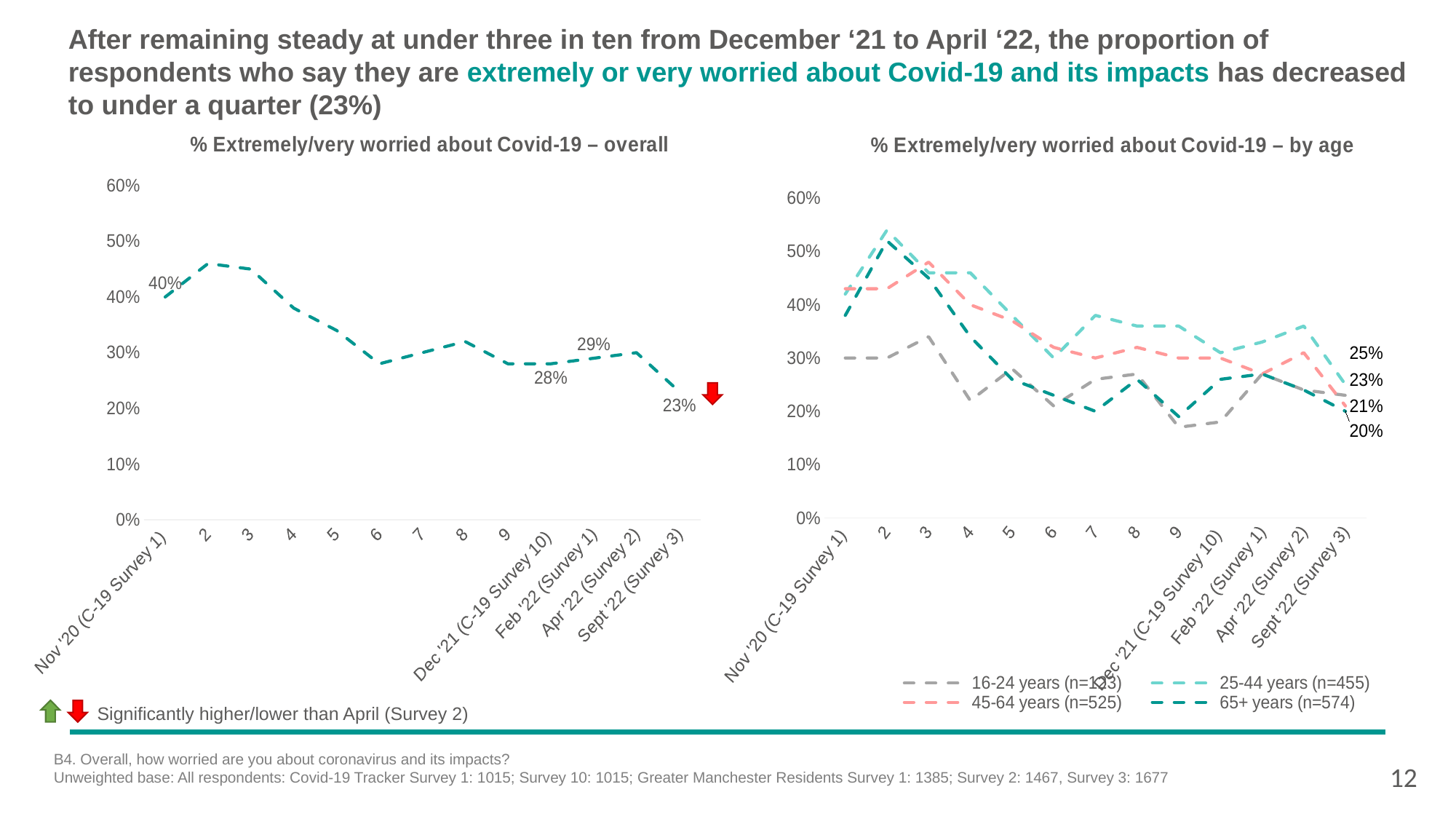
In the '% Extremely/very worried about Covid-19 – by age' chart, what is the value for 65+ years at Sept '22 (Survey 3)? 20% In the '% Extremely/very worried about Covid-19 – overall' chart, is the value at survey point 2 greater or less than 40%? greater In the '% Extremely/very worried about Covid-19 – overall' chart, what is the value for Nov '20 (C-19 Survey 1)? 40% Overall, do the values in the '% Extremely/very worried about Covid-19 – overall' chart rise or fall from Nov '20 to Sept '22? fall In the '% Extremely/very worried about Covid-19 – overall' chart, what is the value for Sept '22 (Survey 3)? 23% What type of chart is the '% Extremely/very worried about Covid-19 – overall' chart? Line chart In the '% Extremely/very worried about Covid-19 – overall' chart, by how many percentage points did the value fall from Nov '20 (C-19 Survey 1) to Sept '22 (Survey 3)? 17 percentage points In the '% Extremely/very worried about Covid-19 – overall' chart, which survey point has the lowest value? Sept '22 (Survey 3) How many age groups does the legend of the '% Extremely/very worried about Covid-19 – by age' chart list? 4 In the '% Extremely/very worried about Covid-19 – by age' chart, which age group has the highest value at Sept '22 (Survey 3)? 25-44 years In the '% Extremely/very worried about Covid-19 – by age' chart, what is the unweighted base (n) shown in the legend for 45-64 years? 525 How many survey points are plotted in the '% Extremely/very worried about Covid-19 – overall' chart? 13